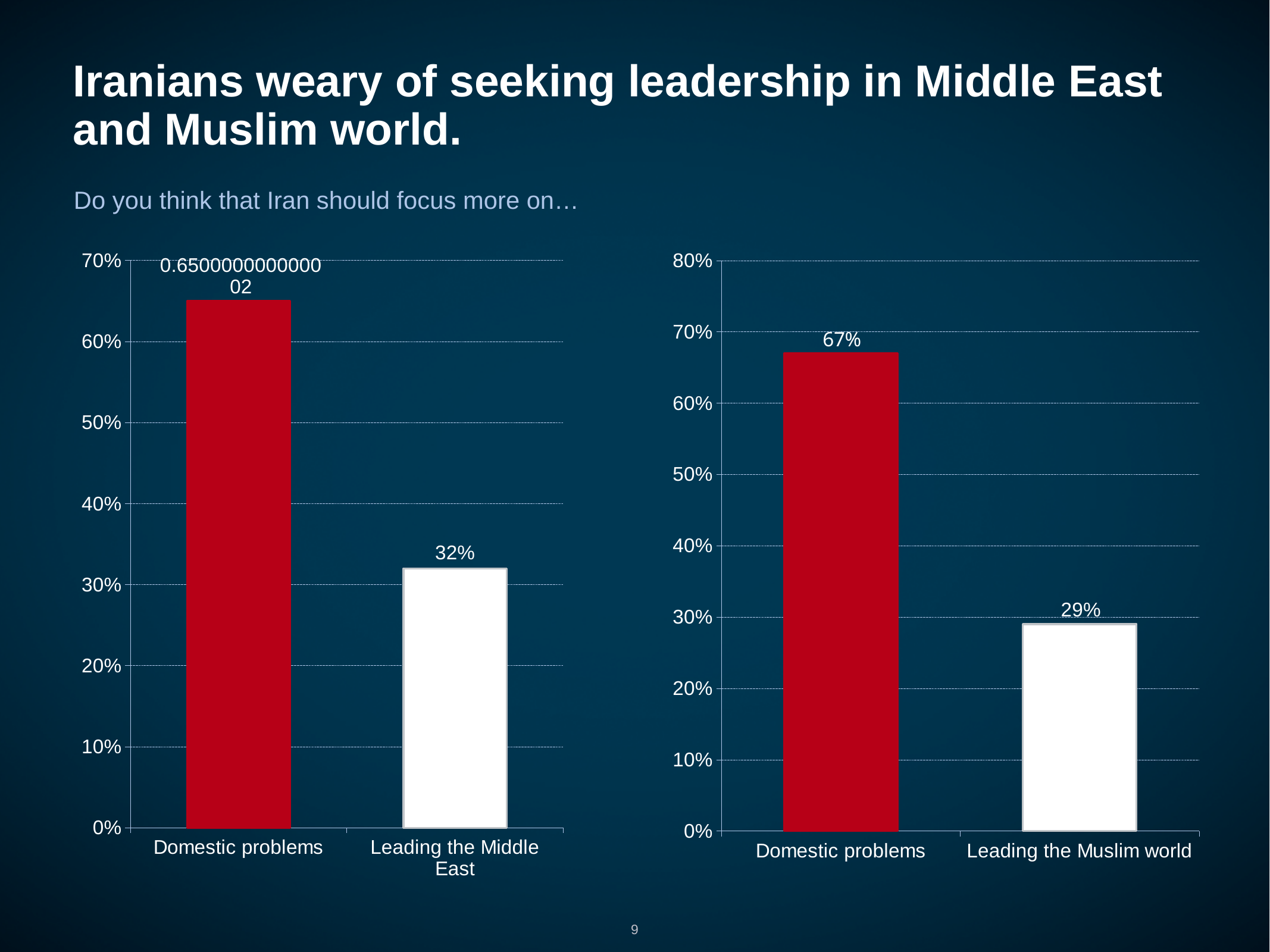
On the left chart, which category has the highest value? Domestic problems On the left chart, what is the value for Leading the Middle East? 32% On the right chart, what is the value for Domestic problems? 67% On the left chart, which is larger: Domestic problems or Leading the Middle East? Domestic problems On the right chart, is the value for Leading the Muslim world greater or less than 30%? less What kind of chart is the left chart? bar chart On the right chart, what is the difference between the values for Domestic problems and Leading the Muslim world? 38% On the right chart, which category has the lowest value? Leading the Muslim world On the right chart, what is the value for Leading the Muslim world? 29% How many categories are shown on the right chart? 2 What colour is the Domestic problems bar on the right chart? red On the left chart, is the value for Domestic problems greater or less than 60%? greater